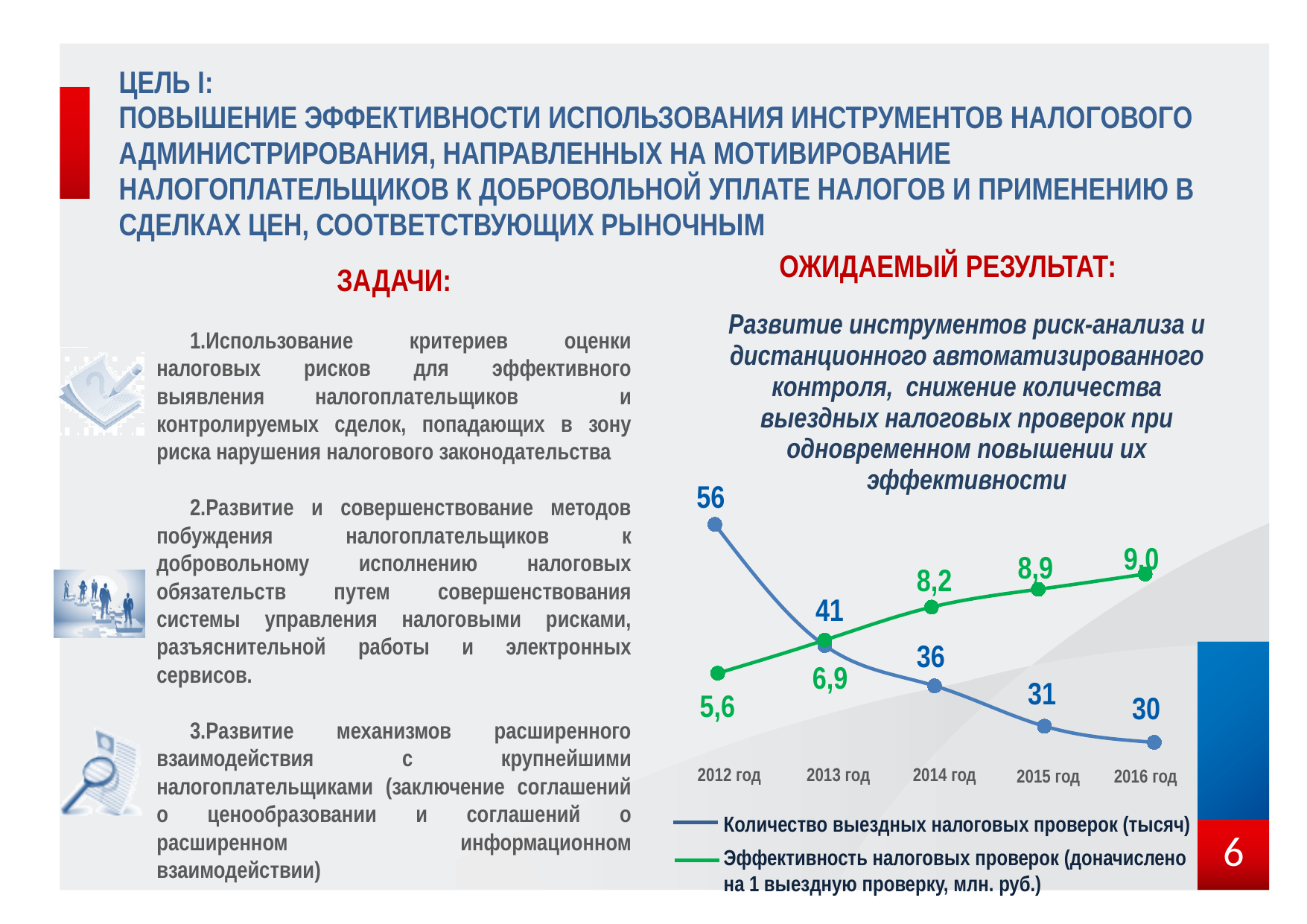
Which colour is used for the 'Эффективность налоговых проверок' line? green What is the difference between the 'Количество выездных налоговых проверок (тысяч)' values for 2012 год and 2013 год? 15 What is the value of 'Количество выездных налоговых проверок (тысяч)' for 2012 год? 56 How many series does the chart legend list? 2 What type of chart is shown on the slide? line chart Does 'Количество выездных налоговых проверок (тысяч)' rise or fall from 2012 год to 2016 год? fall What is the value of 'Количество выездных налоговых проверок (тысяч)' for 2016 год? 30 Which is larger: 'Количество выездных налоговых проверок (тысяч)' in 2014 год or in 2015 год? 2014 год What is the value of 'Эффективность налоговых проверок' for 2014 год? 8,2 How many years are plotted on the x axis of the chart? 5 In which year is 'Количество выездных налоговых проверок (тысяч)' highest? 2012 год In which year is 'Эффективность налоговых проверок' lowest? 2012 год